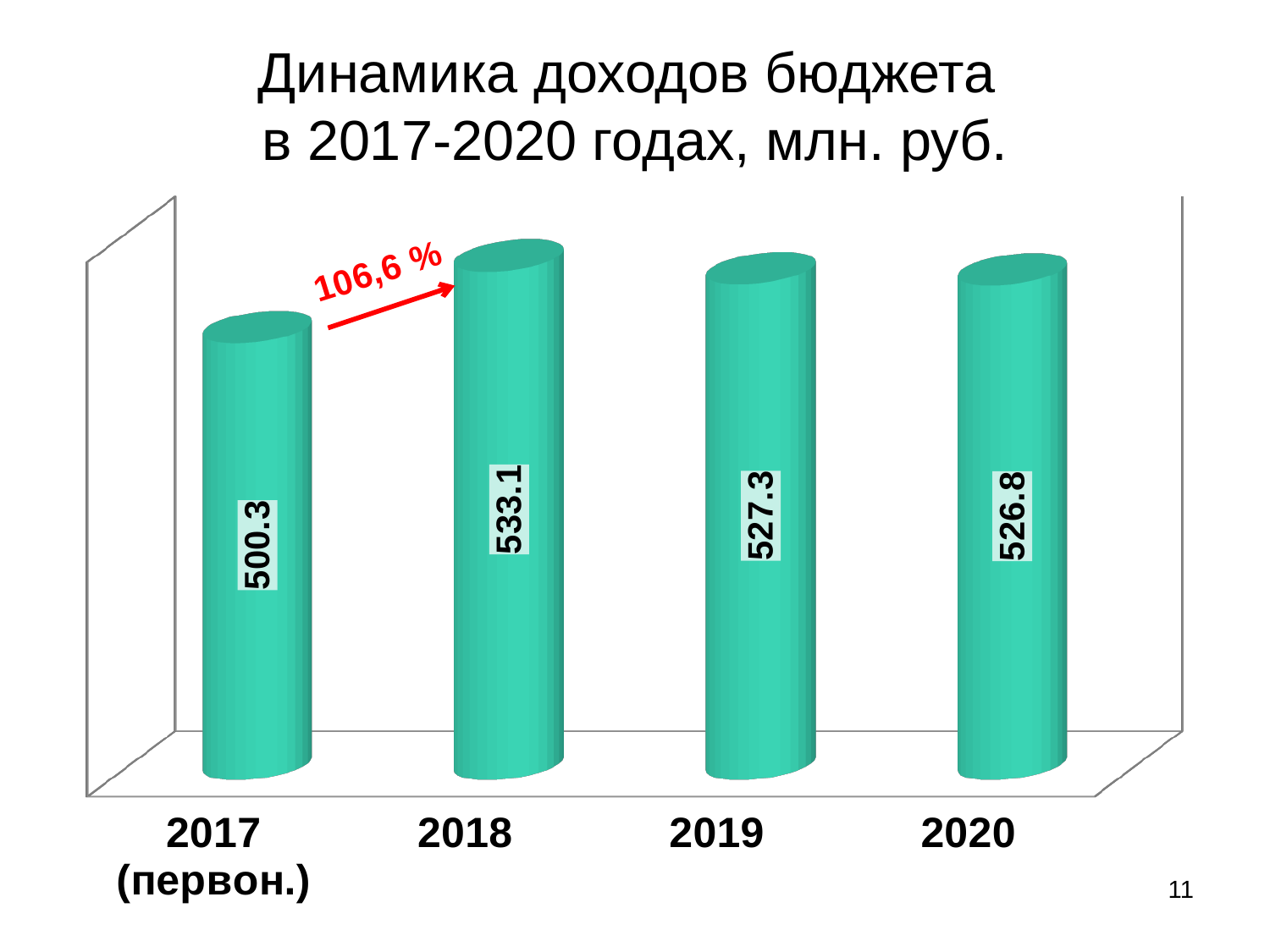
What is the difference between the 2019 and 2020 values? 0.5 What kind of chart is shown on the slide? Bar chart How many years are shown on the chart? 4 Which is larger, the value for 2018 or the value for 2019? 2018 What percentage is written next to the red arrow between 2017 and 2018? 106,6 % What is the value shown for 2020? 526.8 What is the value shown for 2019? 527.3 By how much does the 2018 value exceed the 2017 (первон.) value? 32.8 Which year has the highest budget revenue? 2018 What value is shown for 2017 (первон.)? 500.3 Which year has the lowest budget revenue? 2017 (первон.) What is the budget revenue value shown for 2018? 533.1